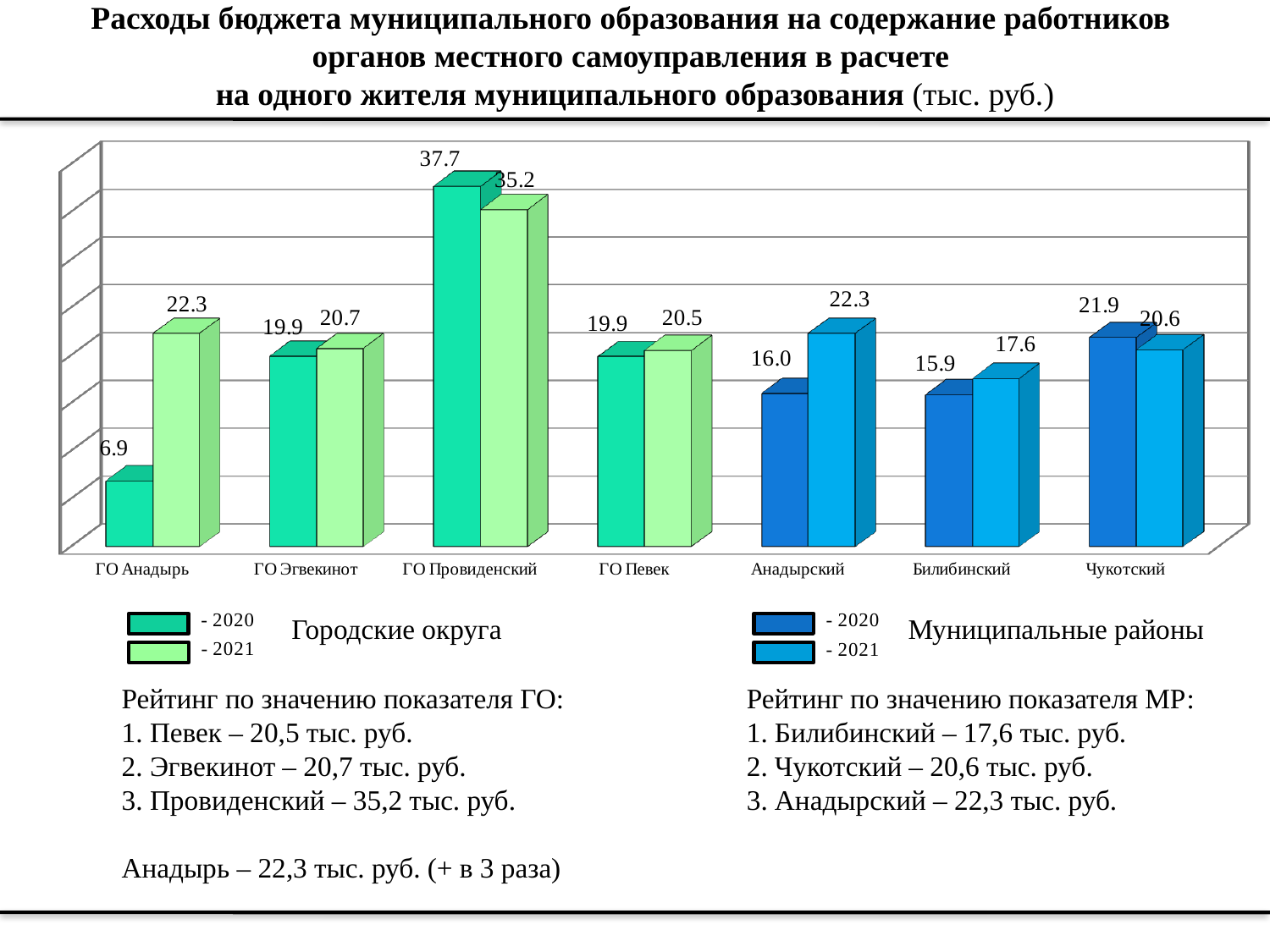
How many categories are shown on the x axis of the chart? 7 What is the 2020 value for Чукотский? 21.9 Which is larger for Чукотский: the 2020 value or the 2021 value? 2020 Which category has the lowest 2020 value? ГО Анадырь What is the difference between the 2021 and 2020 values for ГО Анадырь? 15.4 What kind of chart is shown on the slide? Bar chart What is the 2021 value for Билибинский? 17.6 What is the 2021 value for ГО Провиденский? 35.2 Which category has the lowest 2021 value? Билибинский Which category has the highest 2020 value? ГО Провиденский What is the difference between the 2020 and 2021 values for ГО Провиденский? 2.5 What is the 2020 value for ГО Анадырь? 6.9